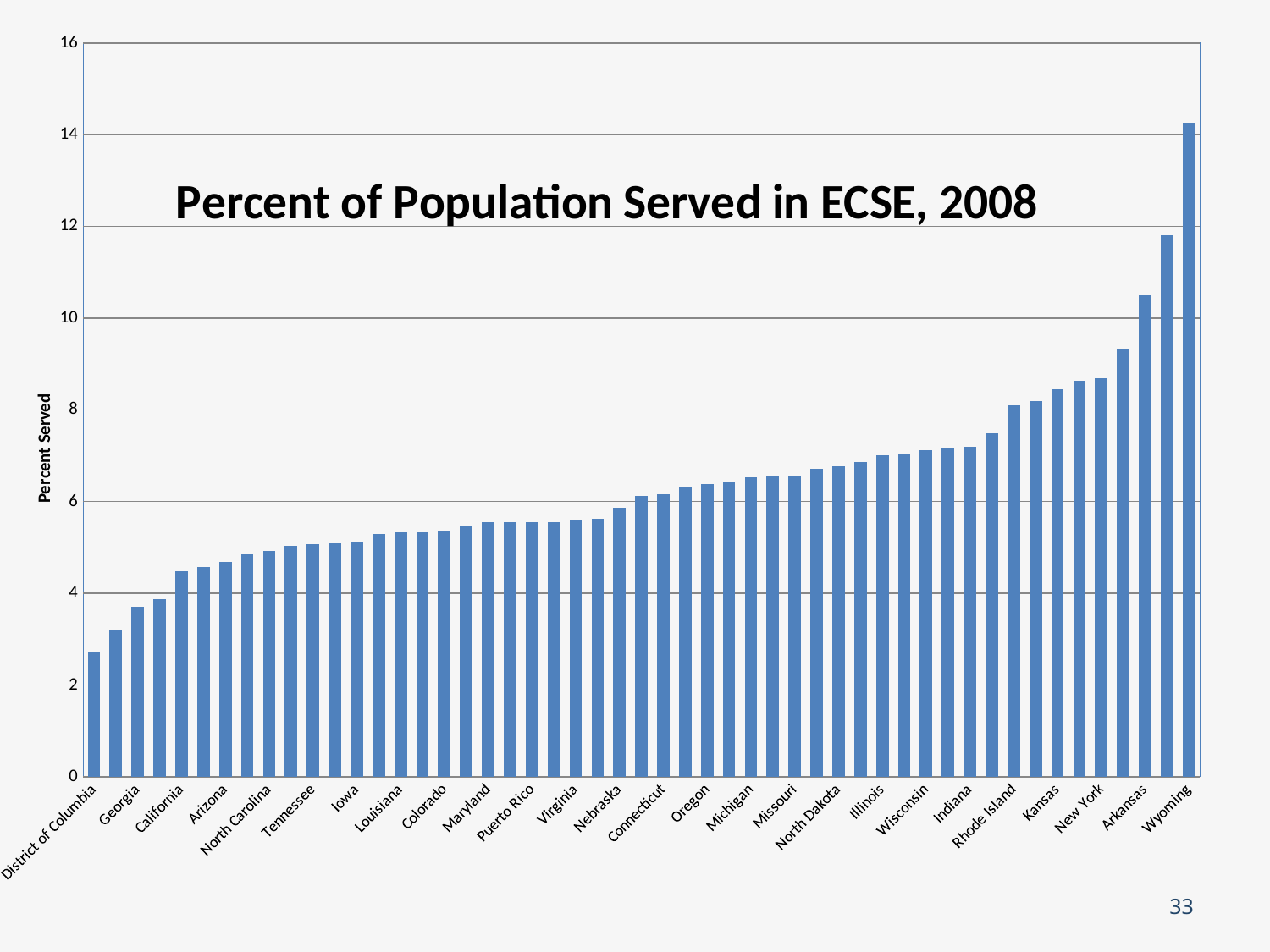
What is the title of the chart? Percent of Population Served in ECSE, 2008 Which has a larger percent served, Wyoming or Arkansas? Wyoming Which labeled category has the lowest percent served? District of Columbia Which labeled state has the highest percent served? Wyoming Is the value for Arkansas greater or less than 10? greater Is the value for Iowa greater or less than 4? greater Is the value for Wyoming greater or less than 12? greater Do the bar values rise or fall from left to right along the x axis? rise What kind of chart is shown on the slide? bar chart What is the label on the vertical axis of the chart? Percent Served Which has a larger percent served, Georgia or District of Columbia? Georgia